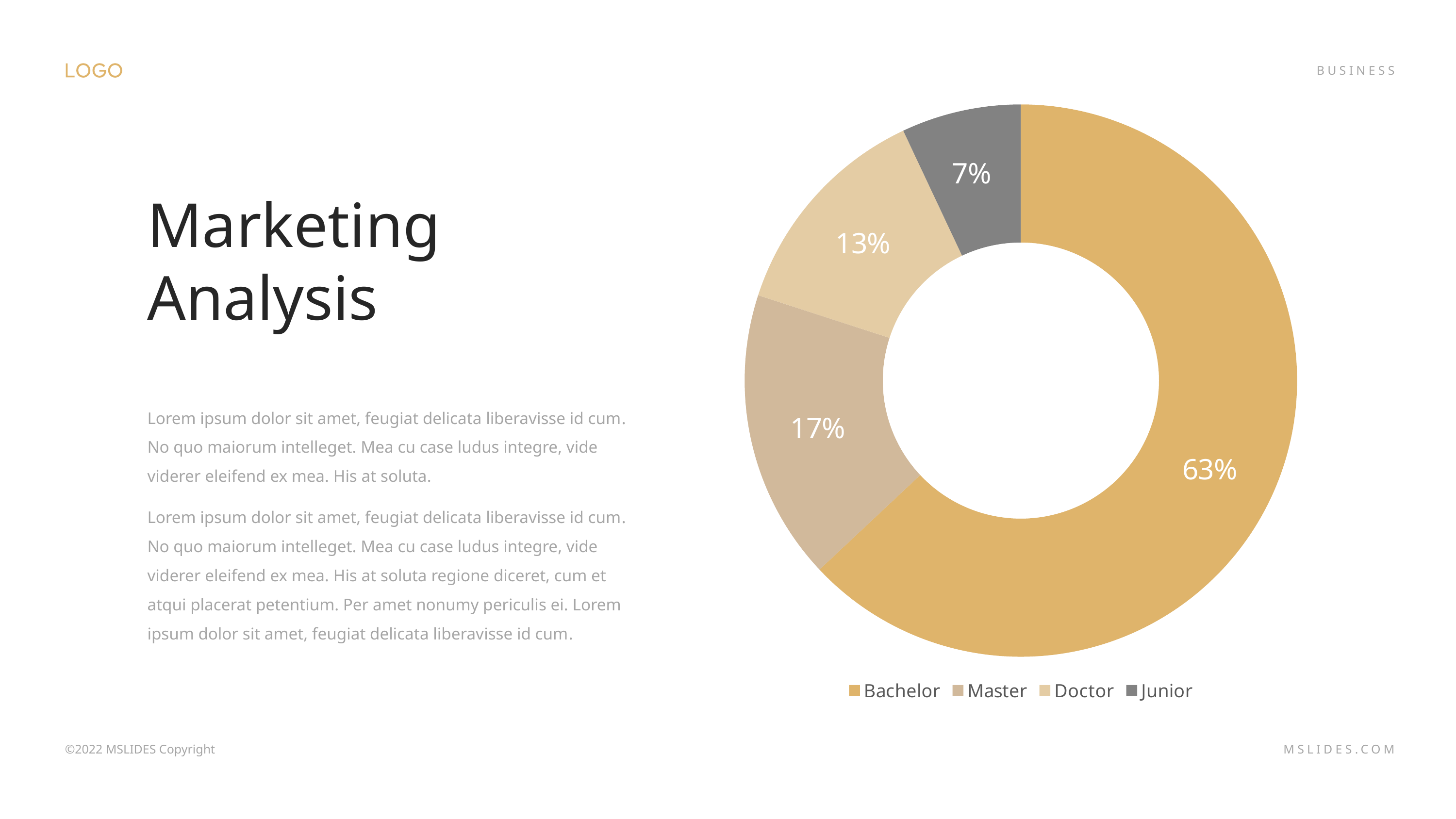
What is the difference in percentage points between the Bachelor and Master slices? 46 How many categories are shown in the chart? 4 What share of the doughnut chart does Doctor hold? 13% Which legend entry is shown in dark grey? Junior What is the difference in percentage points between the Doctor and Junior slices? 6 What kind of chart is shown on the slide? Doughnut chart What share of the doughnut chart does Junior hold? 7% What share of the doughnut chart does Bachelor hold? 63% Which category has the largest slice in the chart? Bachelor What share of the doughnut chart does Master hold? 17% Which category has the smallest slice in the chart? Junior Which slice is larger, Master or Doctor? Master